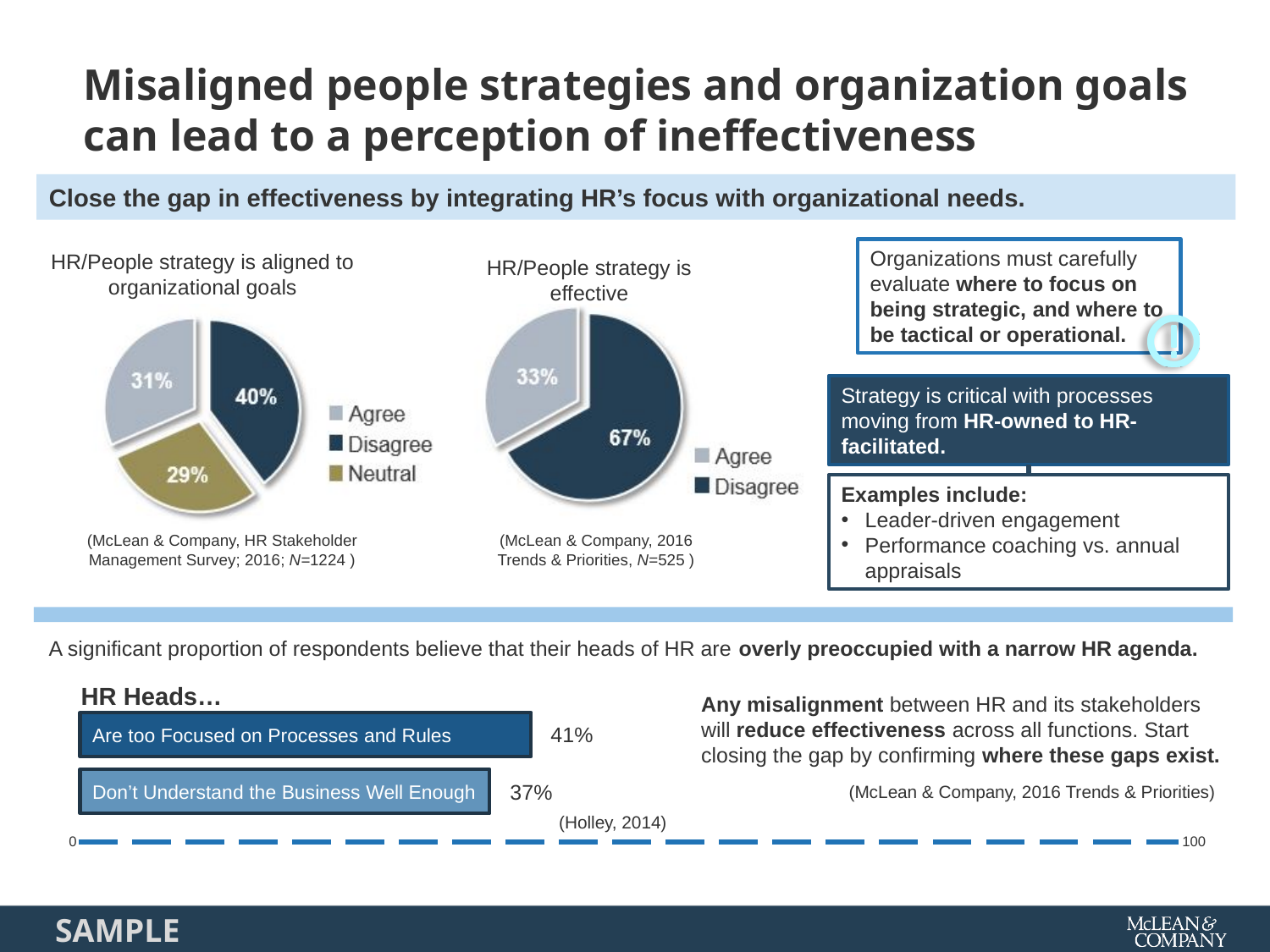
In the 'HR/People strategy is effective' pie chart, what percentage is shown for Agree? 33% In the 'HR Heads…' chart, what value is shown for 'Don't Understand the Business Well Enough'? 37% In the 'HR Heads…' chart, what value is shown for 'Are too Focused on Processes and Rules'? 41% In the 'HR/People strategy is aligned to organizational goals' pie chart, what percentage is shown for Disagree? 40% In the 'HR/People strategy is aligned to organizational goals' pie chart, which response has the largest share? Disagree In the 'HR/People strategy is aligned to organizational goals' pie chart, what percentage is shown for Neutral? 29% In the 'HR/People strategy is aligned to organizational goals' pie chart, how many slices are there? 3 In the 'HR/People strategy is effective' pie chart, what percentage is shown for Disagree? 67% In the 'HR/People strategy is effective' pie chart, how many entries does the legend list? 2 In the 'HR/People strategy is effective' pie chart, what is the difference between the Disagree and Agree shares? 34% What kind of chart is the 'HR Heads…' chart? Bar chart In the 'HR Heads…' chart, what is the difference between the two bar values? 4%